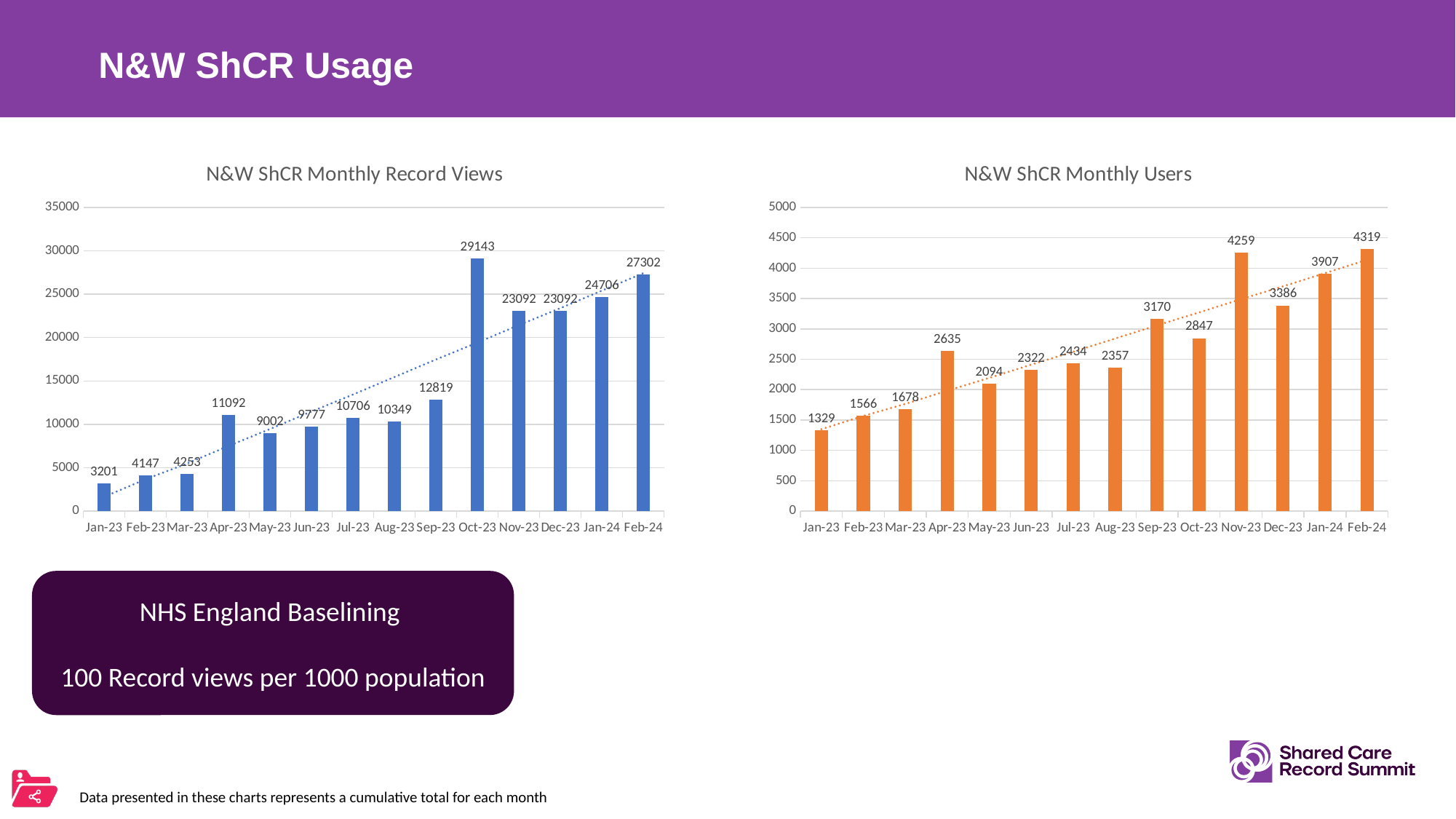
How many months are plotted in the N&W ShCR Monthly Record Views chart? 14 In the N&W ShCR Monthly Users chart, what colour are the bars? Orange In the N&W ShCR Monthly Record Views chart, what is the value for Oct-23? 29143 In the N&W ShCR Monthly Record Views chart, what is the difference between the values for Feb-24 and Jan-24? 2596 In the N&W ShCR Monthly Users chart, is the value for Sep-23 greater or less than 3000? greater In the N&W ShCR Monthly Record Views chart, which month has the highest value? Oct-23 What kind of chart is the N&W ShCR Monthly Users chart? Bar chart In the N&W ShCR Monthly Users chart, which month has the lowest value? Jan-23 In the N&W ShCR Monthly Users chart, which month has the highest value? Feb-24 In the N&W ShCR Monthly Users chart, what is the value for Apr-23? 2635 In the N&W ShCR Monthly Users chart, what is the difference between the values for Nov-23 and Oct-23? 1412 In the N&W ShCR Monthly Record Views chart, which is larger, the value for Jun-23 or the value for Aug-23? Aug-23